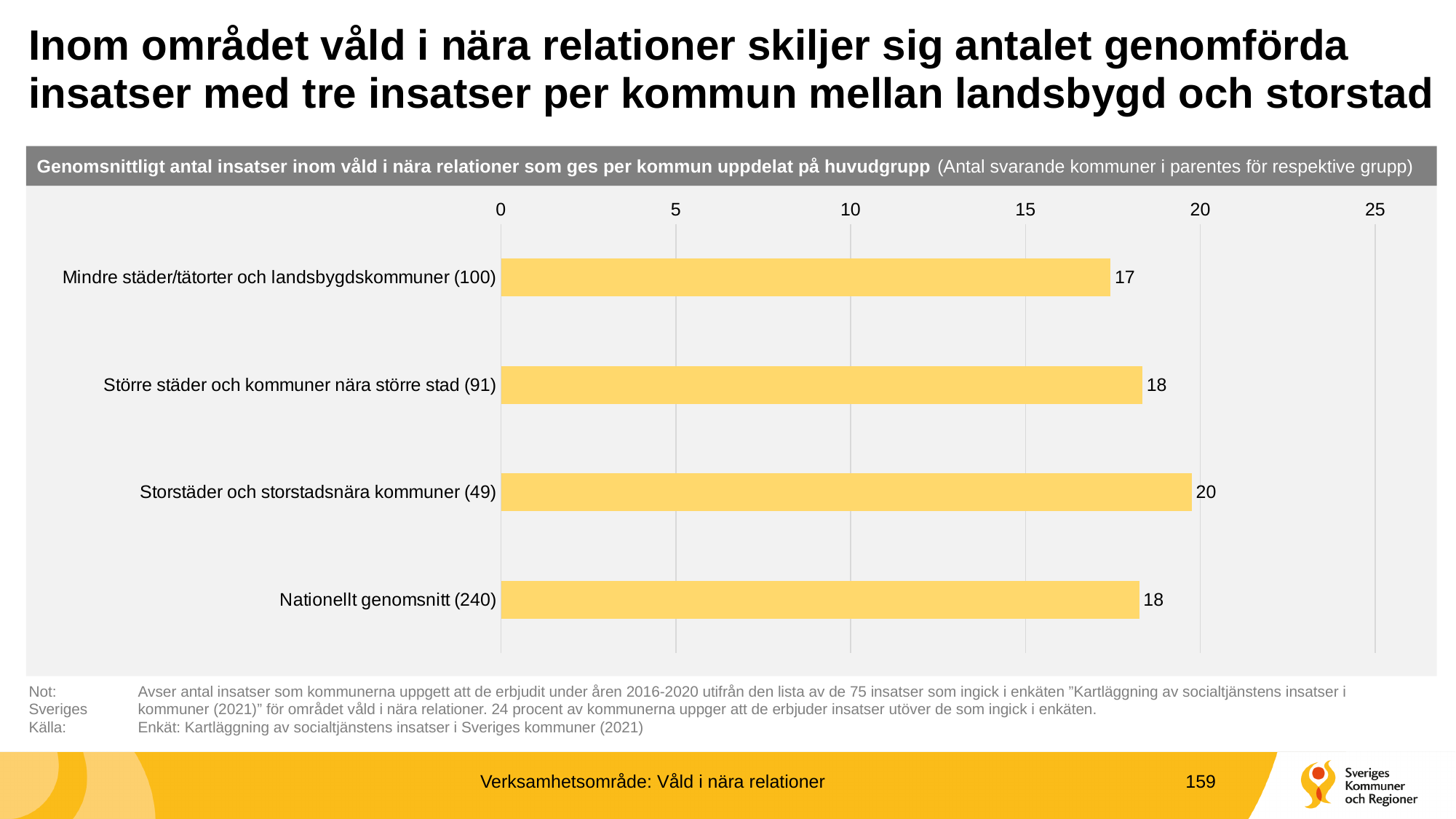
What is the value for Nationellt genomsnitt (240)? 18 What kind of chart is shown on the slide? bar chart Which category has the highest value? Storstäder och storstadsnära kommuner (49) Which is larger, the value for Storstäder och storstadsnära kommuner (49) or the value for Nationellt genomsnitt (240)? Storstäder och storstadsnära kommuner (49) What is the maximum value shown on the chart's axis? 25 How many categories are shown in the chart? 4 Is the value for Storstäder och storstadsnära kommuner (49) greater or less than 15? greater What is the value for Storstäder och storstadsnära kommuner (49)? 20 What is the value for Större städer och kommuner nära större stad (91)? 18 What is the difference between the values for Storstäder och storstadsnära kommuner (49) and Mindre städer/tätorter och landsbygdskommuner (100)? 3 What is the value for Mindre städer/tätorter och landsbygdskommuner (100)? 17 Which category has the lowest value? Mindre städer/tätorter och landsbygdskommuner (100)